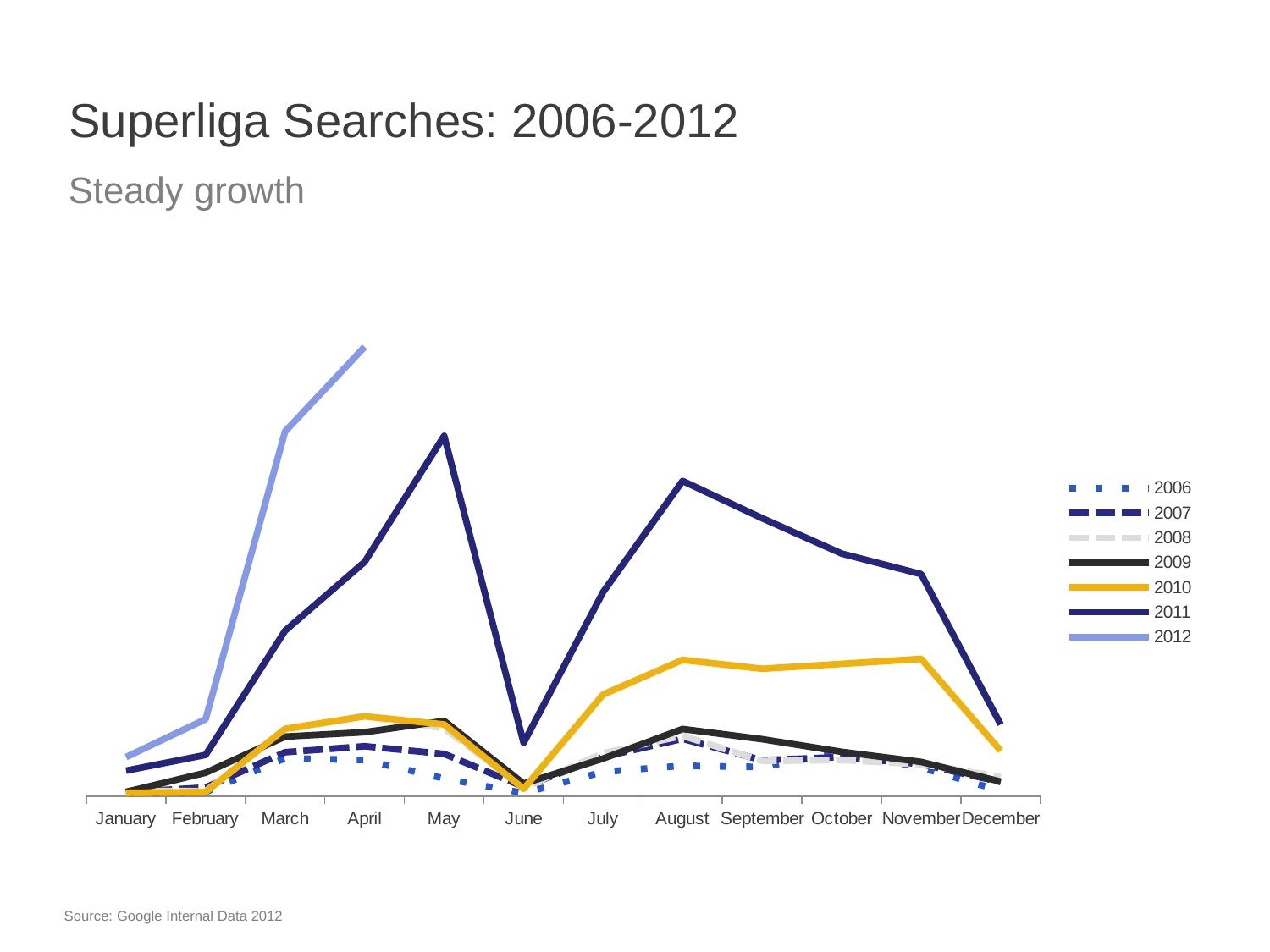
Which series reaches the highest point in April? 2012 In August, which is higher, the 2010 line or the 2009 line? 2010 Does the 2012 line rise or fall from January to April? rise What kind of chart is shown on the slide? line chart Which series has the lowest value in April? 2006 What is the title of the chart slide? Superliga Searches: 2006-2012 In which month does the 2011 line reach its peak? May Through how many months is the 2012 line plotted? 4 How many months are shown along the x axis? 12 How many series does the legend list? 7 Does the 2011 line rise or fall from August to November? fall Which series has the highest value in May? 2011